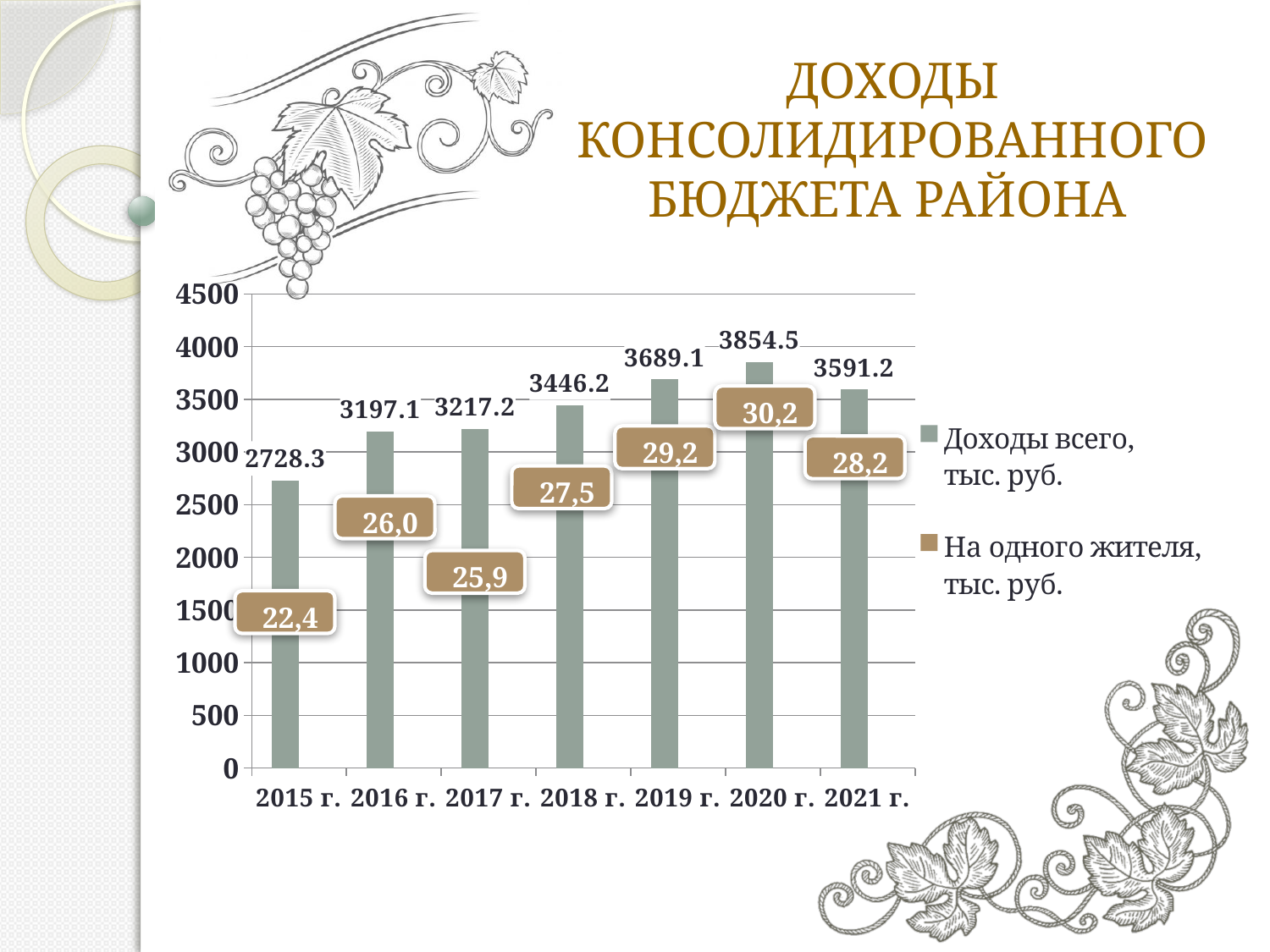
What kind of chart is shown on the slide? bar chart Which is larger: "Доходы всего, тыс. руб." in 2018 г. or in 2021 г.? 2021 г. What is the value of "Доходы всего, тыс. руб." for 2015 г.? 2728.3 What is the value of "Доходы всего, тыс. руб." for 2019 г.? 3689.1 How many series does the legend list? 2 Which year has the lowest value of "На одного жителя, тыс. руб."? 2015 г. What is the title of the slide? ДОХОДЫ КОНСОЛИДИРОВАННОГО БЮДЖЕТА РАЙОНА Which year has the highest value of "Доходы всего, тыс. руб."? 2020 г. Is the value of "Доходы всего, тыс. руб." for 2016 г. greater or less than 3000? greater What is the value of "На одного жителя, тыс. руб." for 2017 г.? 25,9 How many years are shown on the x axis? 7 What is the difference between "Доходы всего, тыс. руб." in 2020 г. and 2021 г.? 263.3